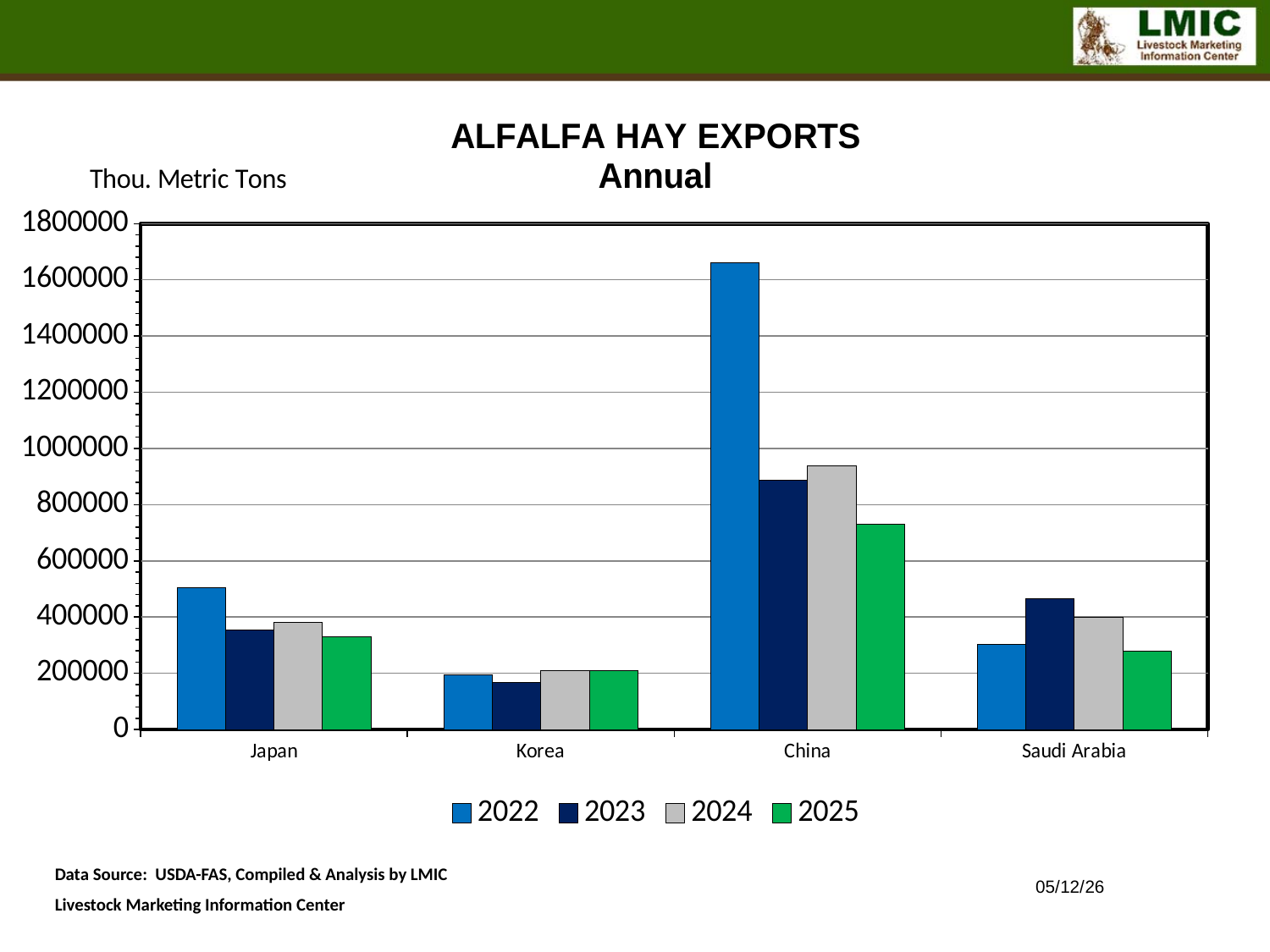
Which year has the highest value for China? 2022 Is the value for China in 2025 greater or less than 800000? less How many countries are shown on the x axis? 4 Is the value for China in 2022 greater or less than 1600000? greater What kind of chart is shown on the slide? bar chart Which is larger, the 2022 value for Japan or the 2022 value for Saudi Arabia? Japan Which year has the lowest value for Korea? 2023 Is the value for Japan in 2022 greater or less than 400000? greater Which country has the highest bar in the chart? China What unit is shown on the y axis label? Thou. Metric Tons How many series does the legend list? 4